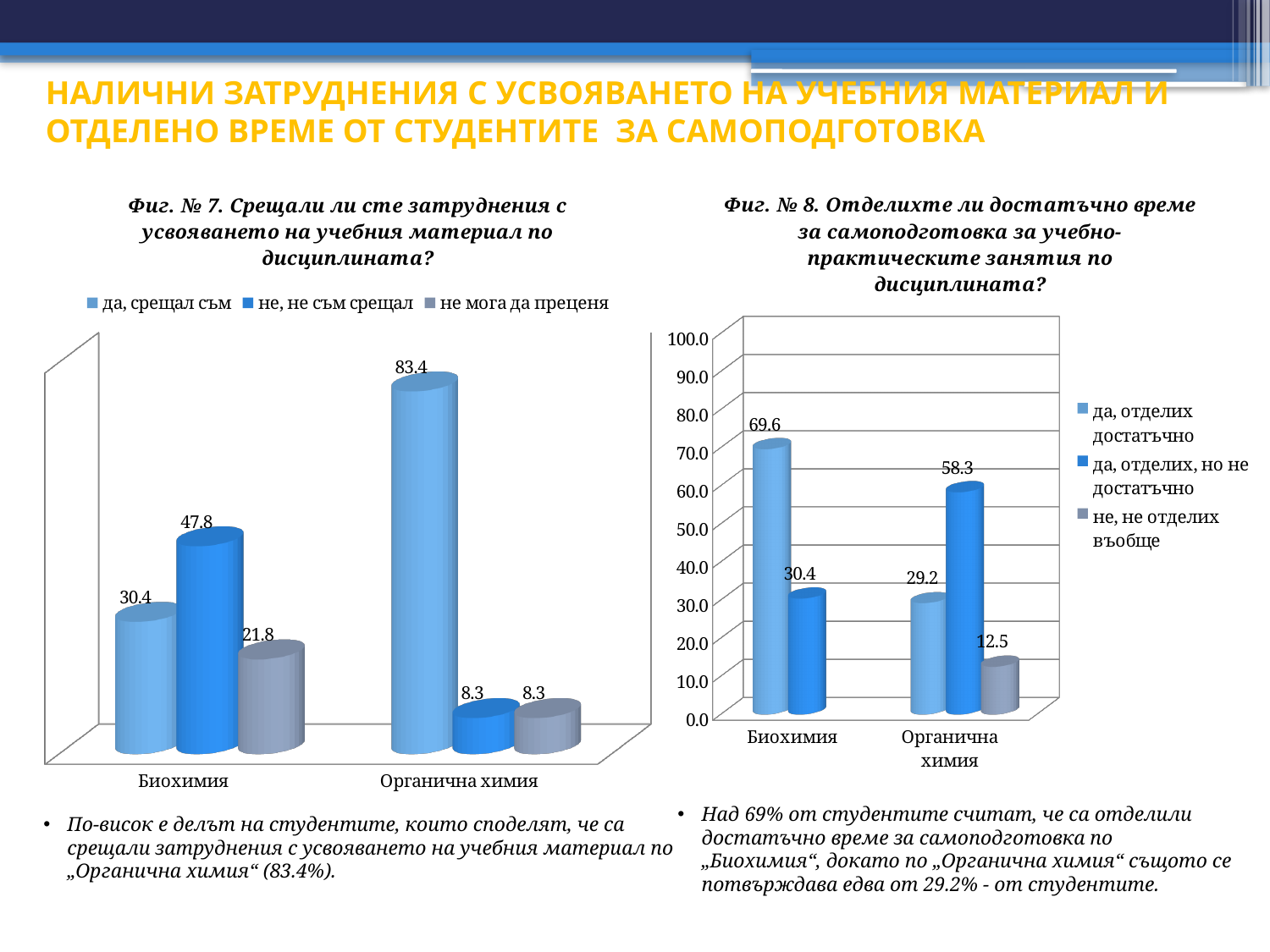
What type of chart is the chart titled "Фиг. № 8" (right)? bar chart In the chart titled "Фиг. № 8" (right), how many categories are shown on the x axis? 2 In the chart titled "Фиг. № 7" (left), what is the value for "да, срещал съм" for Органична химия? 83.4 In the chart titled "Фиг. № 7" (left), what is the value for "не мога да преценя" for Биохимия? 21.8 In the chart titled "Фиг. № 8" (right), what is the value for "да, отделих достатъчно" for Биохимия? 69.6 In the chart titled "Фиг. № 7" (left), which series has the highest value for Биохимия? не, не съм срещал In the chart titled "Фиг. № 8" (right), which is larger for Органична химия: "да, отделих достатъчно" or "да, отделих, но не достатъчно"? да, отделих, но не достатъчно In the chart titled "Фиг. № 8" (right), what is the difference between "да, отделих, но не достатъчно" for Органична химия and for Биохимия? 27.9 In the chart titled "Фиг. № 8" (right), what is the value for "не, не отделих въобще" for Органична химия? 12.5 In the chart titled "Фиг. № 7" (left), how many series does the legend list? 3 In the chart titled "Фиг. № 7" (left), what is the value for "не, не съм срещал" for Биохимия? 47.8 In the chart titled "Фиг. № 7" (left), what is the difference between "да, срещал съм" for Органична химия and for Биохимия? 53.0